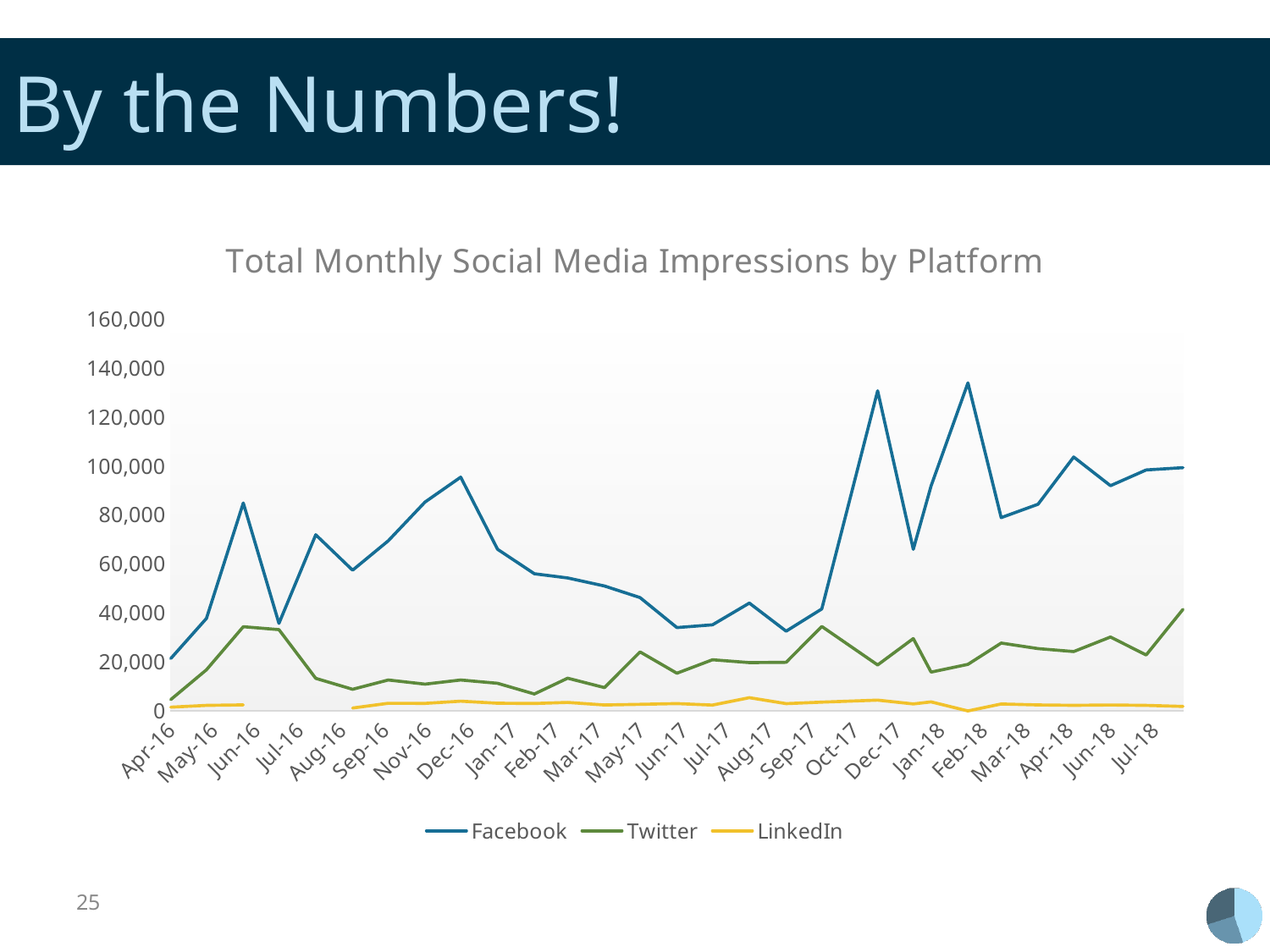
Which is larger at Dec-16, the Facebook value or the Twitter value? Facebook Which platform has the lowest impressions across the whole period? LinkedIn Is the LinkedIn value for Aug-17 greater or less than 20,000? less Is the Twitter value for Jun-16 greater or less than 20,000? greater Is the Facebook value for Feb-18 greater or less than 120,000? greater What kind of chart is shown on the slide? Line chart Which platform is represented by the yellow line? LinkedIn Which platform has the highest impressions across the whole period? Facebook Do Facebook impressions rise or fall from Dec-16 to Jun-17? Fall How many series does the legend list? 3 What is the title of the chart? Total Monthly Social Media Impressions by Platform